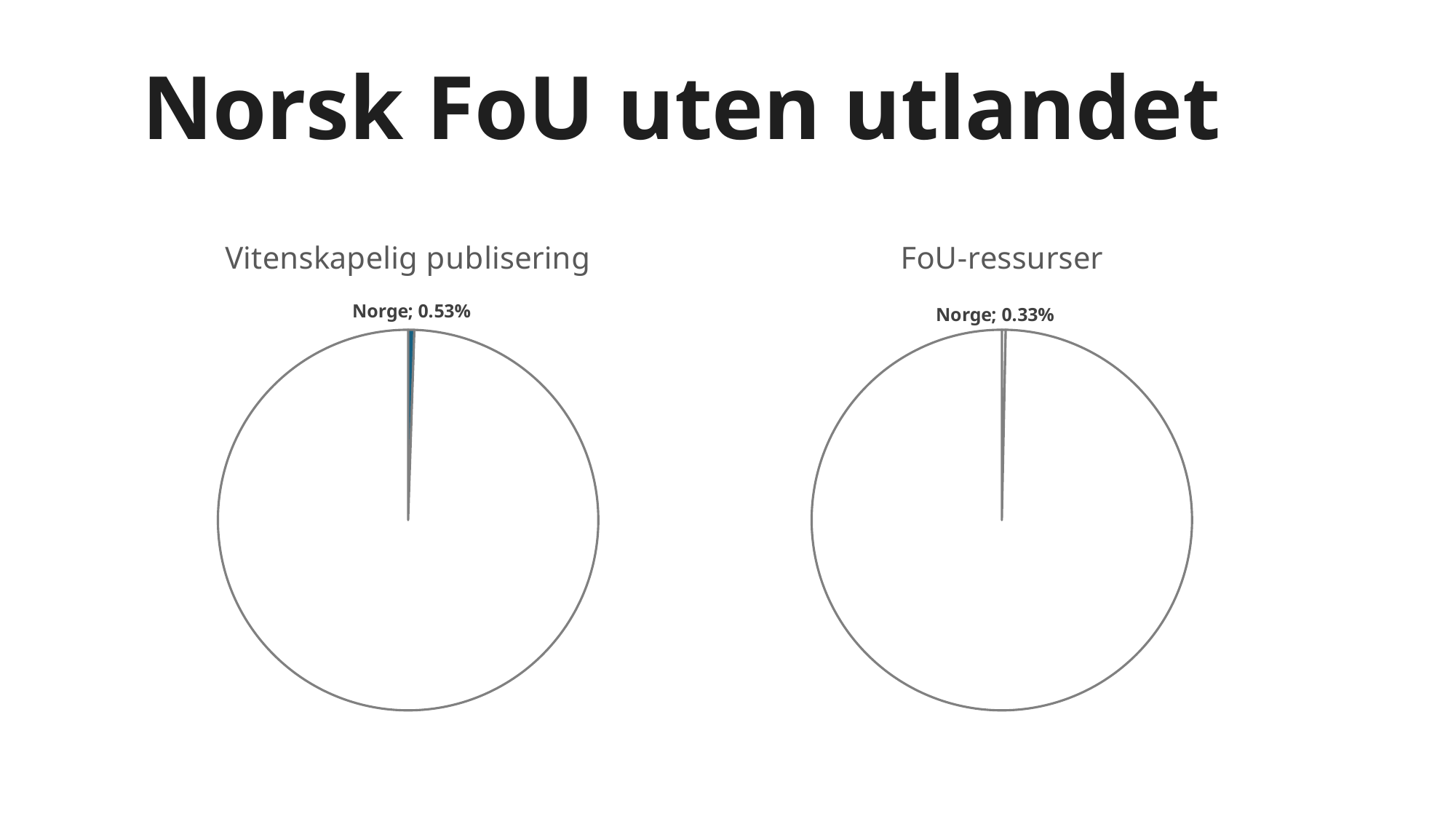
Is the Norge share larger in the 'Vitenskapelig publisering' chart or in the 'FoU-ressurser' chart? Vitenskapelig publisering In the 'Vitenskapelig publisering' chart, what value is printed for Norge? 0.53% What kind of chart is the 'FoU-ressurser' chart? Pie chart What kind of chart is the 'Vitenskapelig publisering' chart? Pie chart What is the title of the chart on the left of the slide? Vitenskapelig publisering What is the title of the chart on the right of the slide? FoU-ressurser What is the difference between the Norge share in the 'Vitenskapelig publisering' chart and the Norge share in the 'FoU-ressurser' chart? 0.20% In the 'FoU-ressurser' chart, what share does the Norge slice have? 0.33% In the 'Vitenskapelig publisering' chart, what share does the Norge slice have? 0.53% In the 'FoU-ressurser' chart, what value is printed for Norge? 0.33%